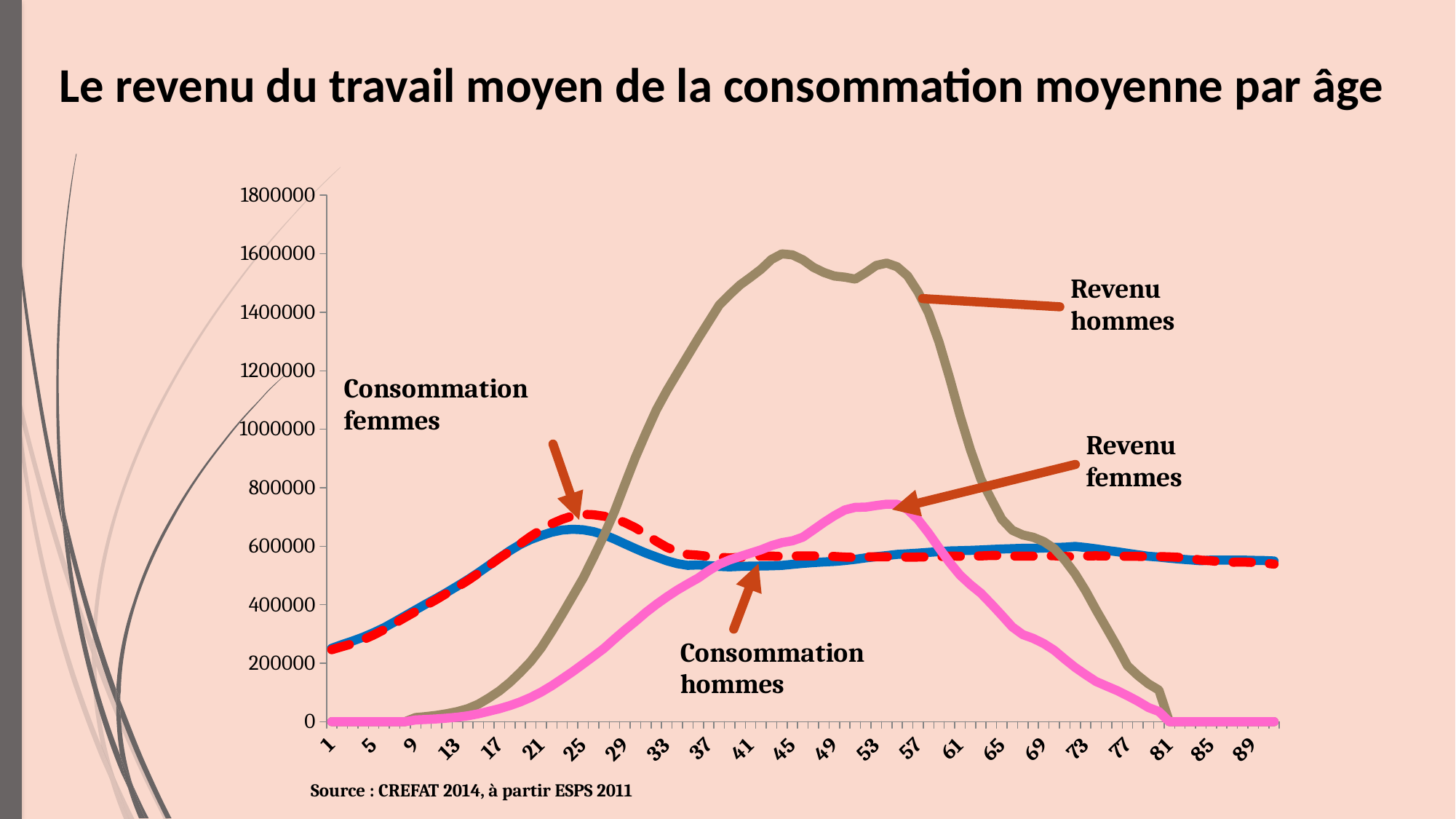
Is the value of Revenu hommes at age 45 greater or less than 1400000? greater Does the Revenu hommes series rise or fall between age 57 and age 81? fall Is the value of Revenu femmes at age 53 greater or less than 600000? greater Is the value of Consommation femmes at age 25 greater or less than 600000? greater What is the value of Revenu femmes at age 1? 0 At age 25, which is higher: Consommation femmes or Consommation hommes? Consommation femmes What kind of chart is shown on the slide? line chart What is the title of the chart on the slide? Le revenu du travail moyen de la consommation moyenne par âge Which series reaches the highest value on the chart? Revenu hommes At age 45, which is higher: Revenu hommes or Revenu femmes? Revenu hommes How many data series are labelled on the chart? 4